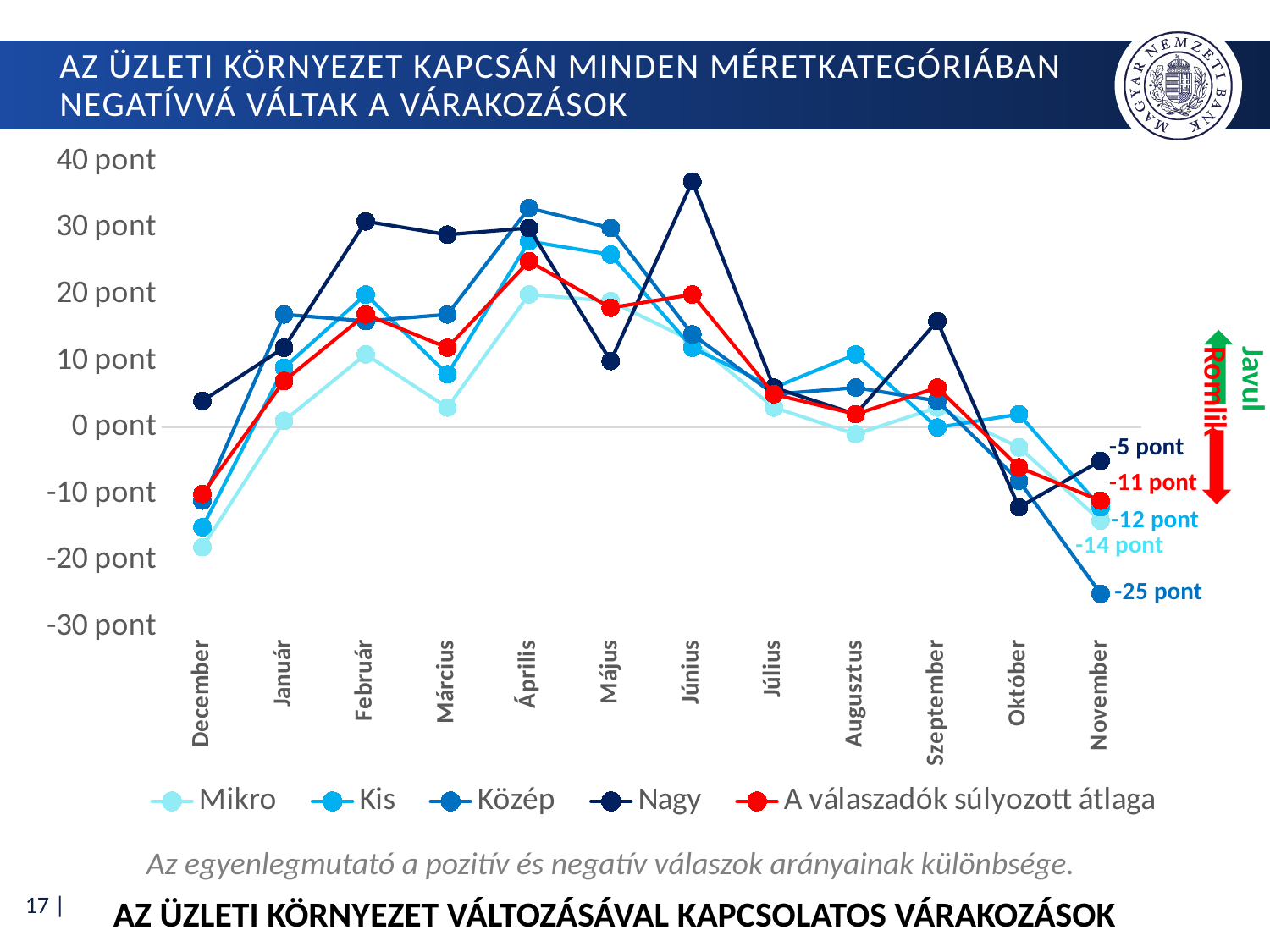
What is the difference between the Nagy and Közép values in November? 20 pont In November, which is larger: the value for Kis or the value for Mikro? Kis What is the value for A válaszadók súlyozott átlaga in November? -11 pont Is the value for Mikro in December greater or less than -10 pont? less How many months are shown along the x axis? 12 How many series does the legend list? 5 What kind of chart is shown on the slide? line chart Which series has the lowest value in November? Közép What is the value for Nagy in November? -5 pont What is the value for Közép in November? -25 pont What is the value for Mikro in November? -14 pont Is the value for Nagy in Június greater or less than 30 pont? greater